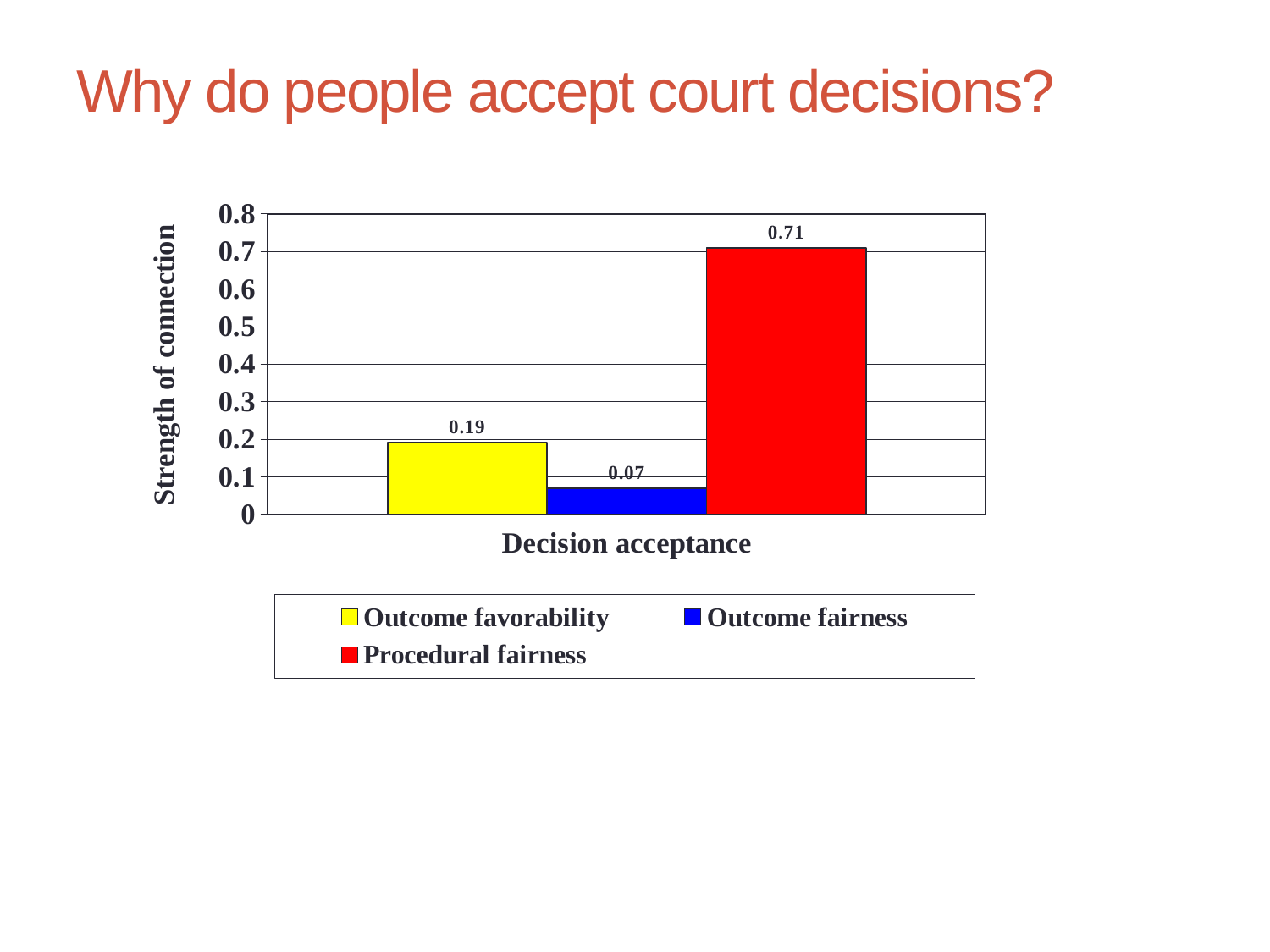
What kind of chart is shown on the slide? bar chart What is the difference between the values for Procedural fairness and Outcome favorability? 0.52 What is the value for Procedural fairness? 0.71 How many series does the legend list? 3 What is the value for Outcome fairness? 0.07 Which series has the highest value? Procedural fairness What is the value for Outcome favorability? 0.19 Which is larger, the value for Outcome favorability or the value for Outcome fairness? Outcome favorability What is the difference between the values for Outcome favorability and Outcome fairness? 0.12 Which series has the lowest value? Outcome fairness What is the label of the vertical axis? Strength of connection Is the value for Procedural fairness greater or less than 0.5? greater